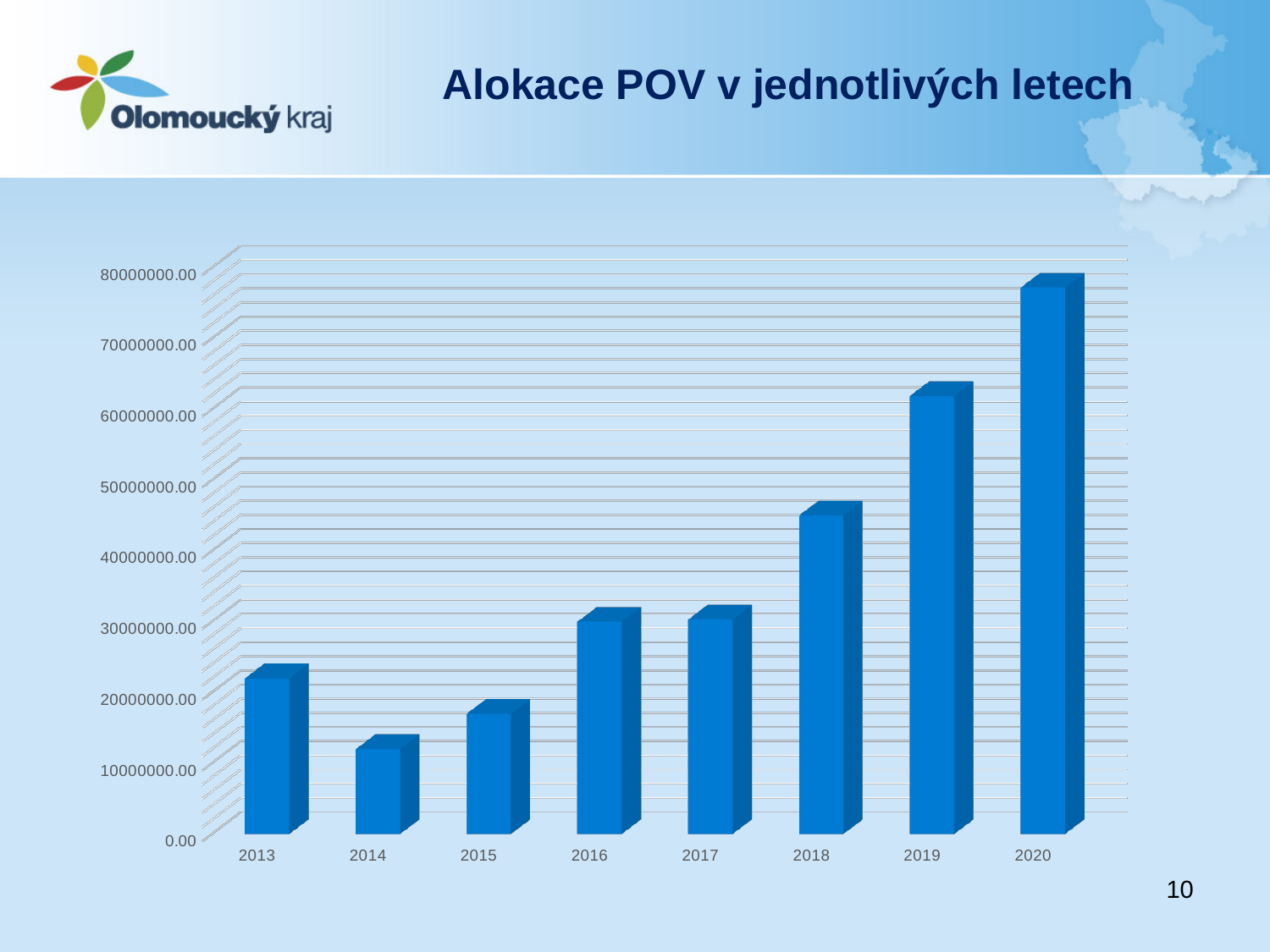
Which year has the lowest value in the chart? 2014 How many years are shown on the x axis of the chart? 8 Is the value for 2020 greater or less than 70000000.00? greater What is the title of the slide's chart? Alokace POV v jednotlivých letech Is the value for 2015 greater or less than 20000000.00? less What kind of chart is shown on the slide? bar chart Is the value for 2018 greater or less than 50000000.00? less Which year has the highest value in the chart? 2020 From 2018 to 2020, do the values rise or fall? rise Which year has the larger value, 2019 or 2018? 2019